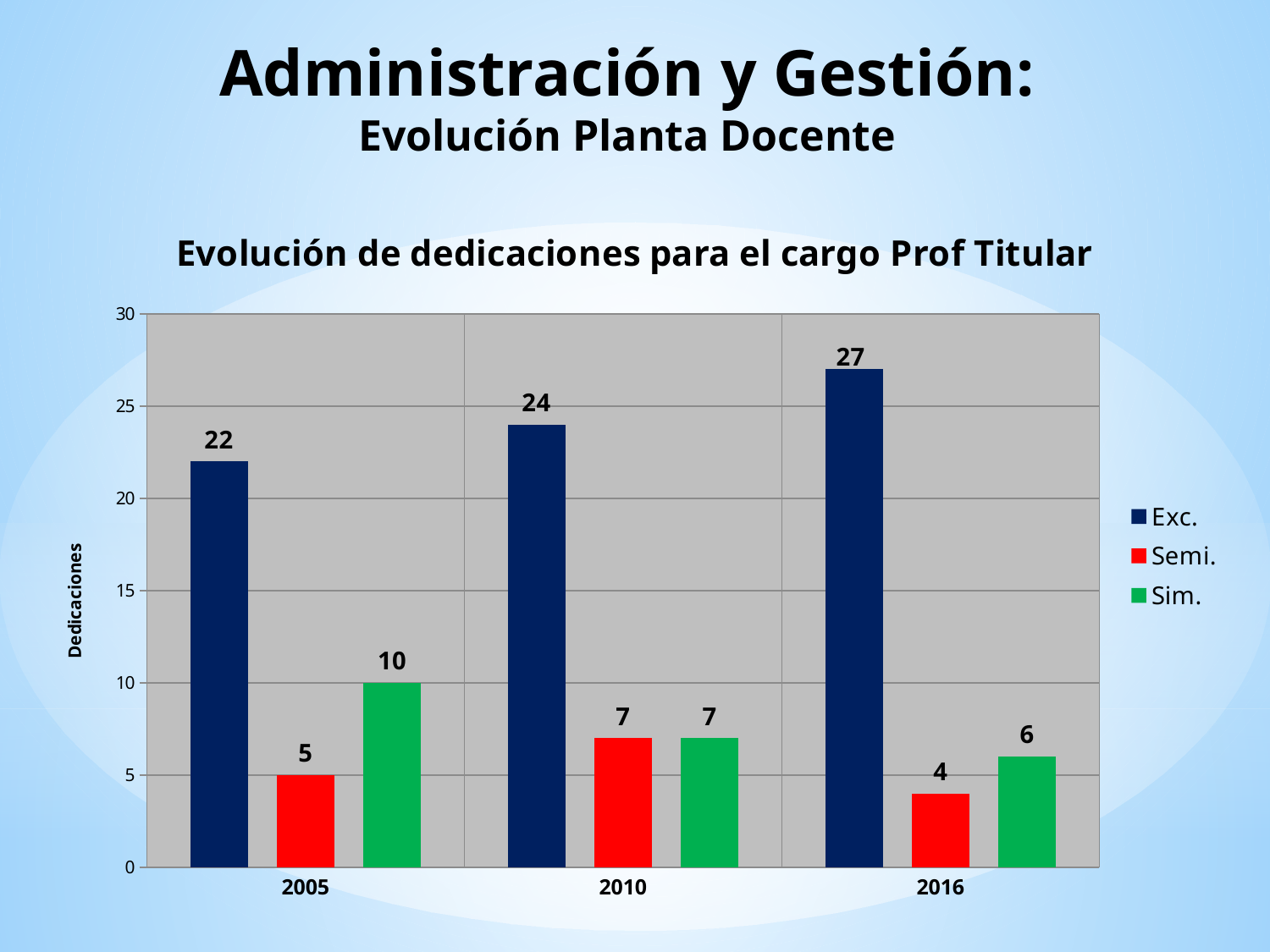
How many years are shown on the x axis? 3 In which year is the Semi. value lowest? 2016 What is the value for Exc. in 2005? 22 What is the value for Semi. in 2016? 4 How many series does the legend list? 3 Is the value for Exc. in 2010 greater or less than 20? greater In which year is the Exc. value highest? 2016 What kind of chart is shown? Bar chart Which is larger in 2005, Semi. or Sim.? Sim. What is the difference between the Exc. values for 2016 and 2005? 5 What is the value for Sim. in 2010? 7 Does the Exc. series rise or fall from 2005 to 2016? Rise